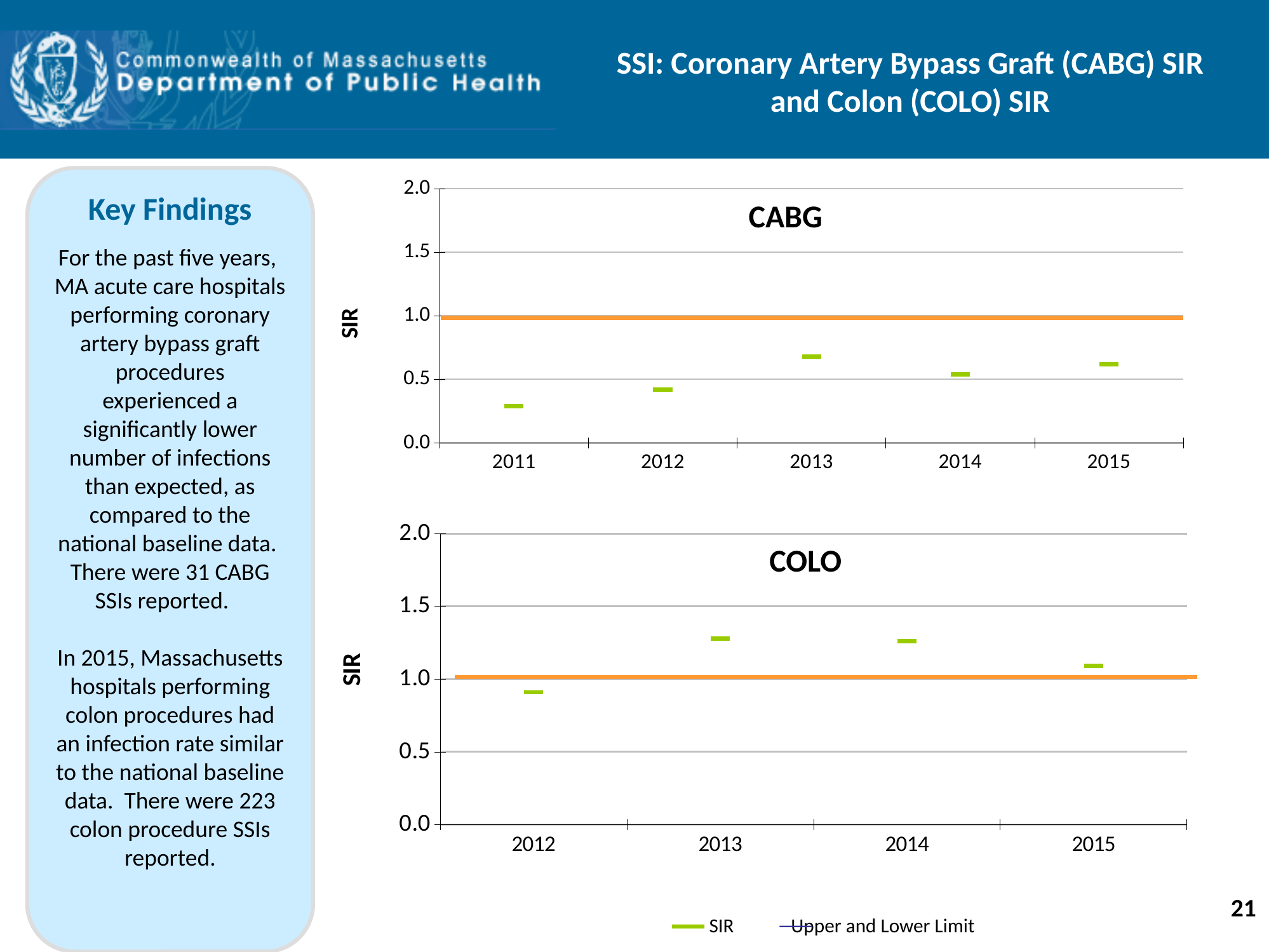
On the CABG chart, how many years are shown on the x axis? 5 How many series does the legend list? 2 On the CABG chart, which year has the larger SIR, 2011 or 2013? 2013 On the COLO chart, how many years are shown on the x axis? 4 On the CABG chart, which year has the lowest SIR? 2011 On the COLO chart, is the SIR for 2013 greater or less than 1.0? greater On the COLO chart, is the SIR for 2012 greater or less than 1.0? less On the CABG chart, is the SIR for 2013 greater or less than 0.5? greater On the COLO chart, which year has the lowest SIR? 2012 What are the two entries in the legend? SIR; Upper and Lower Limit